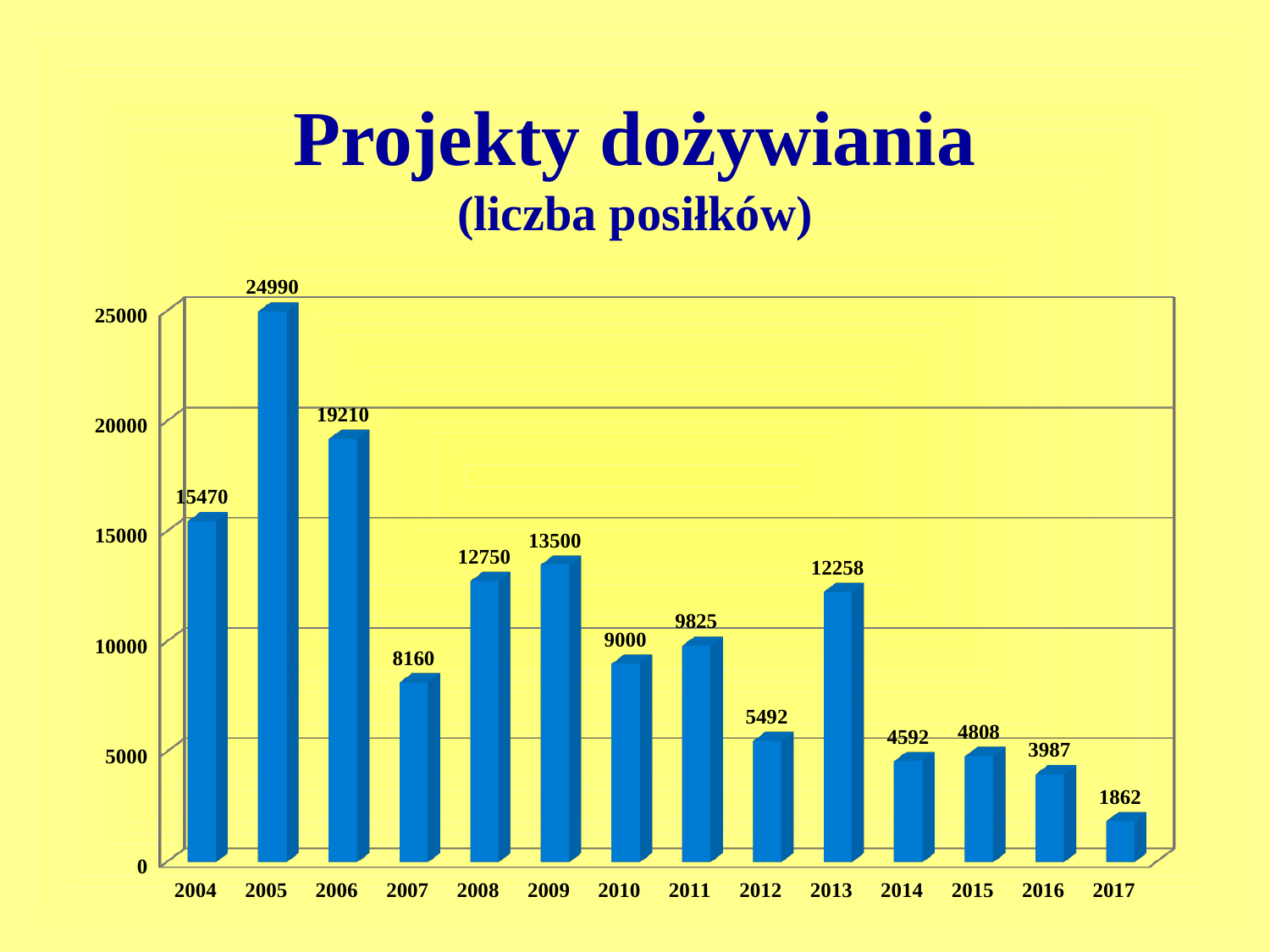
What is the value for 2005? 24990 Which year has the lowest value? 2017 What is the difference between the values for 2009 and 2008? 750 What is the title of the chart? Projekty dożywiania (liczba posiłków) What is the value for 2017? 1862 Which is larger, the value for 2011 or the value for 2010? 2011 What is the value for 2013? 12258 How many years are shown on the x axis? 14 What is the difference between the values for 2005 and 2006? 5780 Which year has the highest value? 2005 Is the value for 2007 greater or less than 10000? less What kind of chart is shown on the slide? bar chart